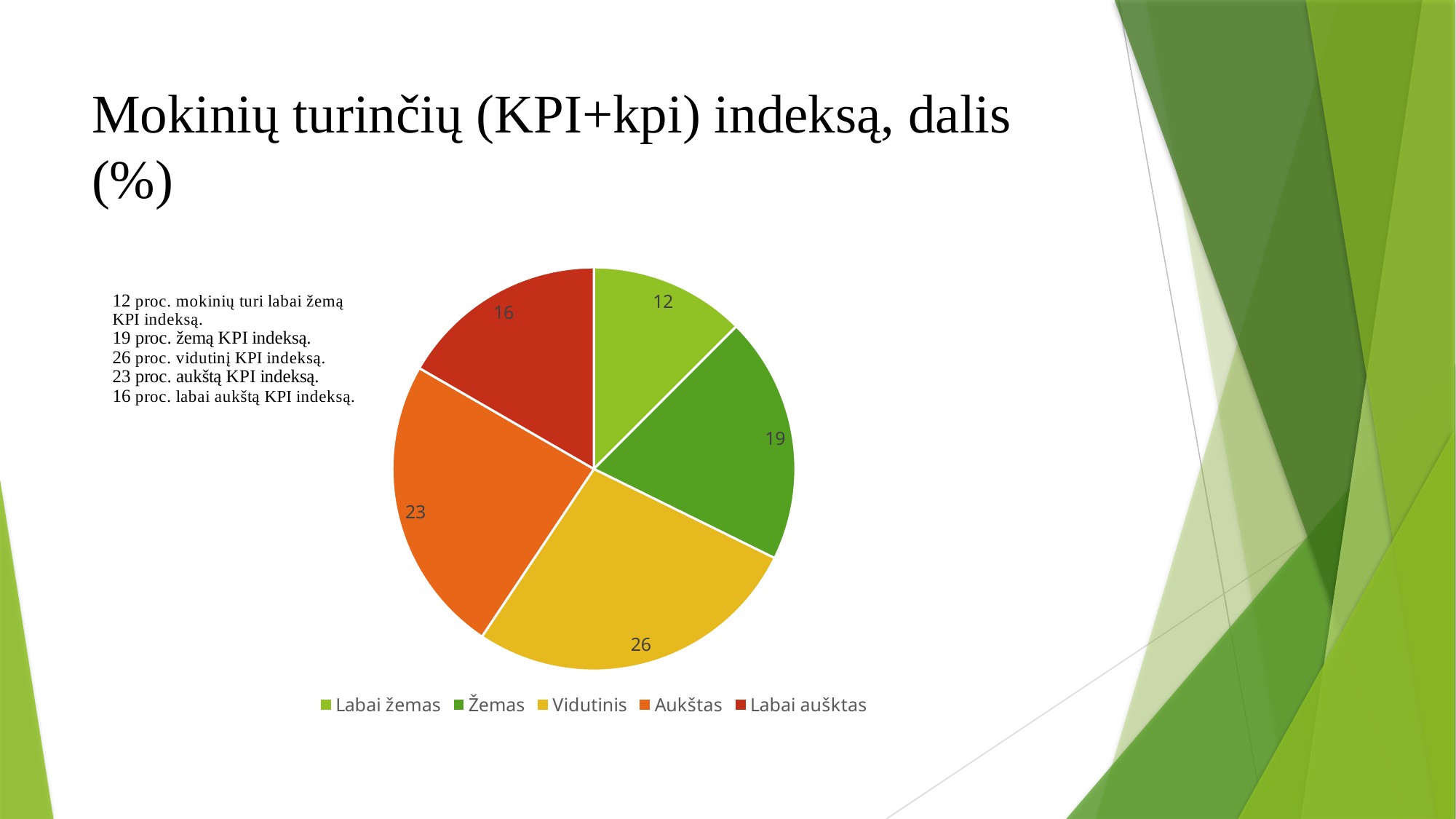
What is the value for Labai aušktas? 16 What kind of chart is shown on the slide? pie chart Which is larger, Žemas or Labai aušktas? Žemas What is the value for Aukštas? 23 Which category has the smallest slice? Labai žemas Which category has the largest slice? Vidutinis What is the value for Vidutinis? 26 How many entries does the legend list? 5 What is the value for Žemas? 19 What is the difference between the values for Vidutinis and Aukštas? 3 What is the value for Labai žemas? 12 How many slices does the pie chart have? 5